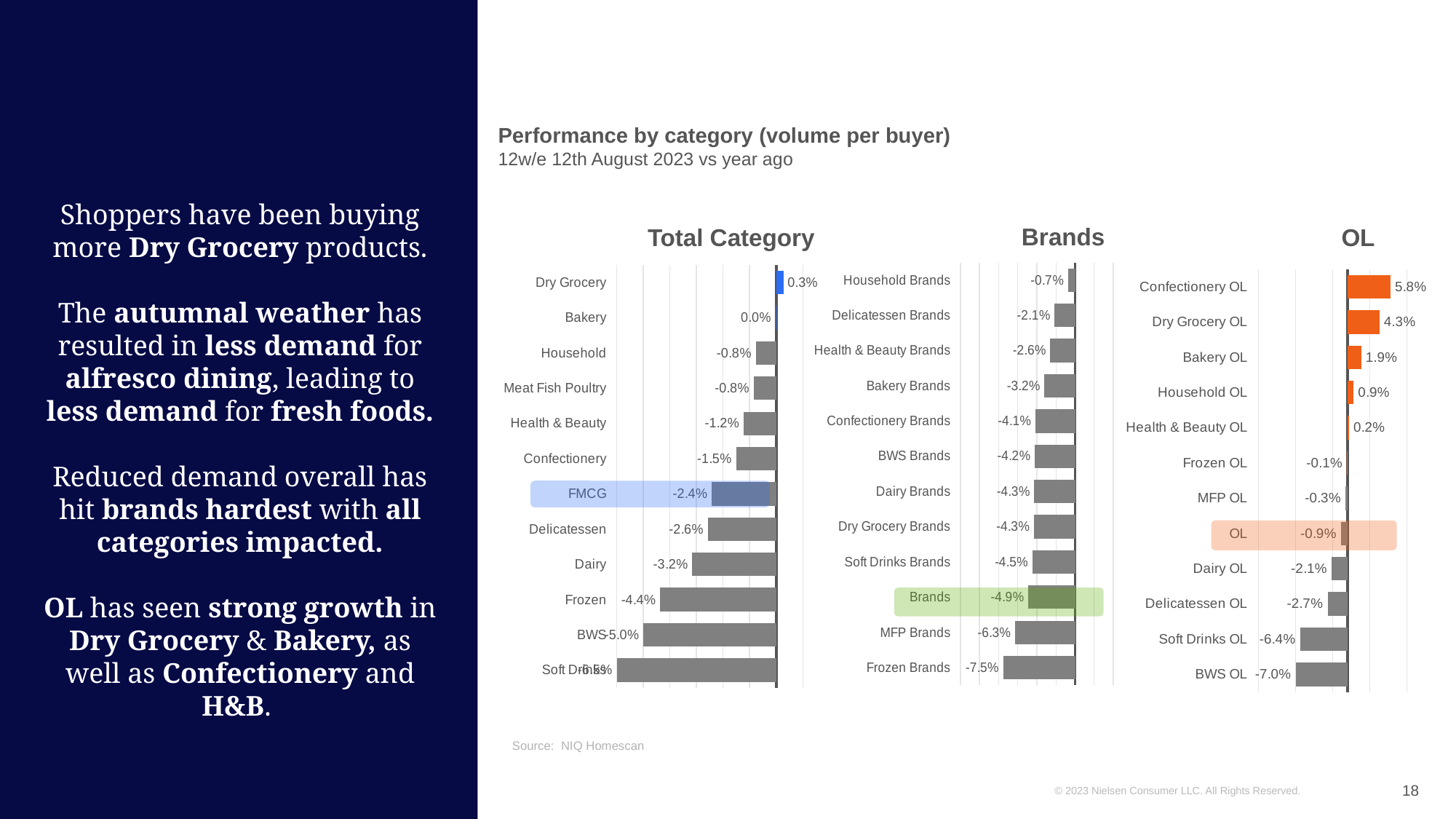
What kind of chart is the Total Category chart? Bar chart In the Total Category chart, what is the value for Dry Grocery? 0.3% In the OL chart, what is the value for Confectionery OL? 5.8% In the Brands chart, what is the value for Frozen Brands? -7.5% How many categories are plotted in the Brands chart? 12 In the Brands chart, which category has the lowest value? Frozen Brands In the Brands chart, what is the value for Household Brands? -0.7% In the Total Category chart, what is the value for FMCG? -2.4% In the OL chart, what is the difference between Confectionery OL (5.8%) and Dry Grocery OL (4.3%)? 1.5 percentage points In the Total Category chart, which is larger, the value for Dairy or the value for Frozen? Dairy In the OL chart, which category has the highest value? Confectionery OL What is the title of the chart section on the slide? Performance by category (volume per buyer)